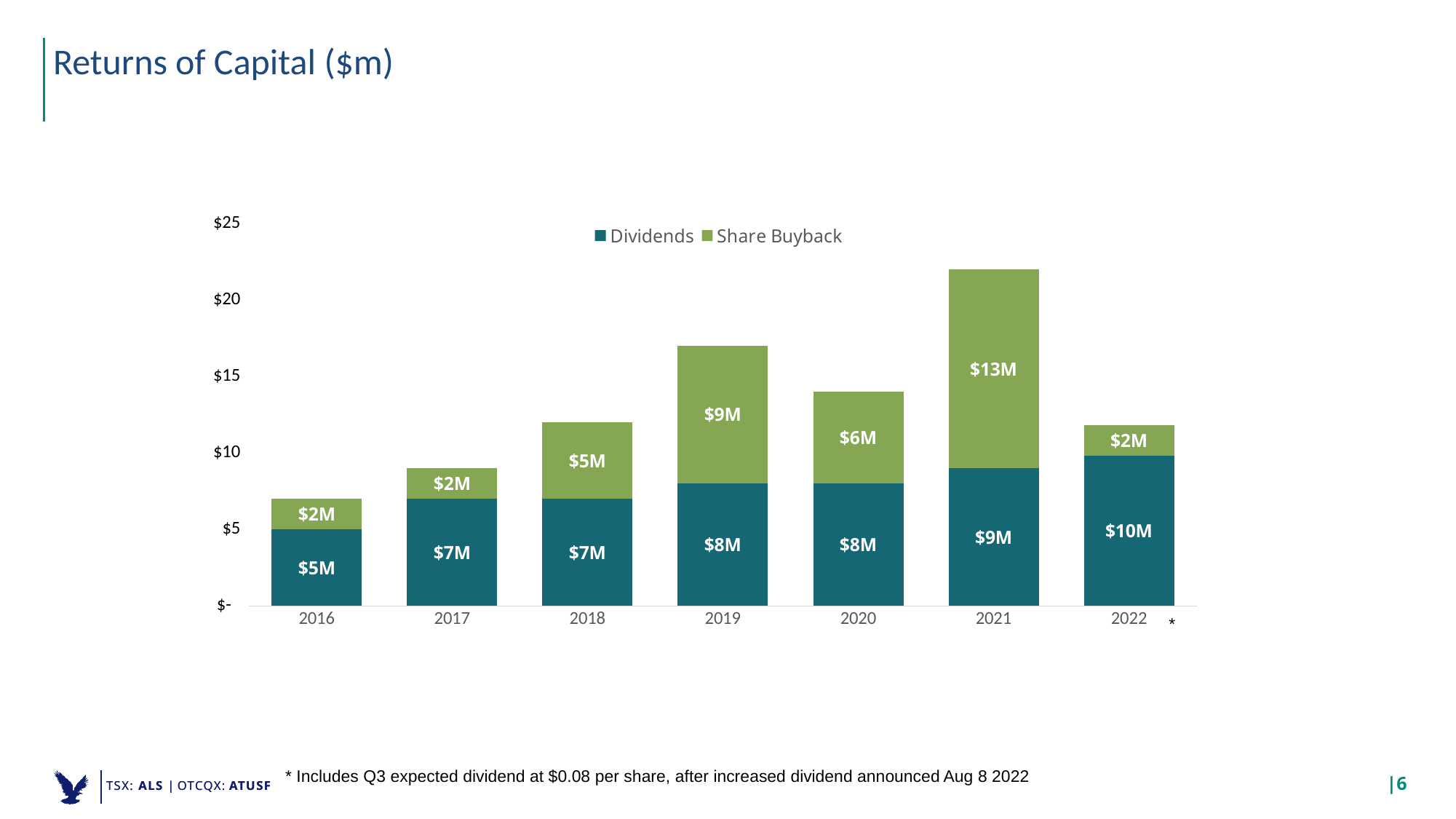
Do the Dividends values rise or fall from 2016 to 2022? Rise What is the total of the stacked bar for 2021? $22M Which is larger, the Share Buyback value for 2019 or for 2018? 2019 What is the Share Buyback value for 2021? $13M How many series does the legend list? 2 What is the difference between the Share Buyback values for 2021 and 2020? $7M What is the Dividends value for 2022? $10M Which year has the highest Share Buyback value? 2021 What kind of chart is shown on the slide? Stacked bar chart How many years are shown on the x axis? 7 What is the Dividends value for 2019? $8M Which year has the lowest Dividends value? 2016